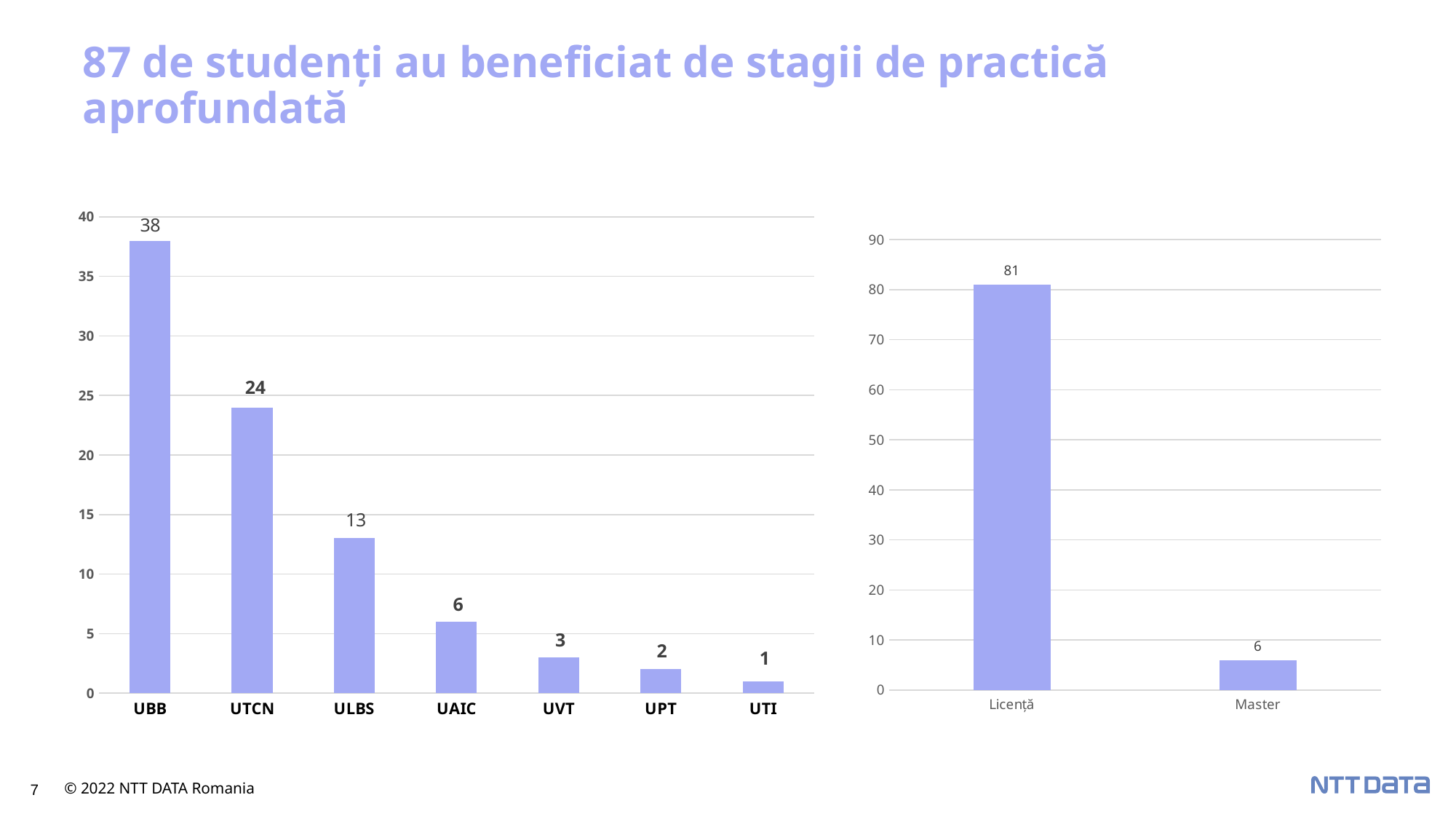
In the left chart, which category has the lowest value? UTI In the right chart, what is the value for Licență? 81 In the left chart, what is the value for ULBS? 13 In the left chart, do the values rise or fall from UBB to UTI? fall In the left chart, what is the difference between the values for UBB and UTCN? 14 In the left chart, which category has the highest value? UBB In the right chart, what is the difference between the values for Licență and Master? 75 What kind of chart is the left chart? bar chart How many categories are shown in the left chart? 7 In the left chart, what is the value for UBB? 38 In the left chart, which is larger, the value for UAIC or the value for UVT? UAIC How many categories are shown in the right chart? 2